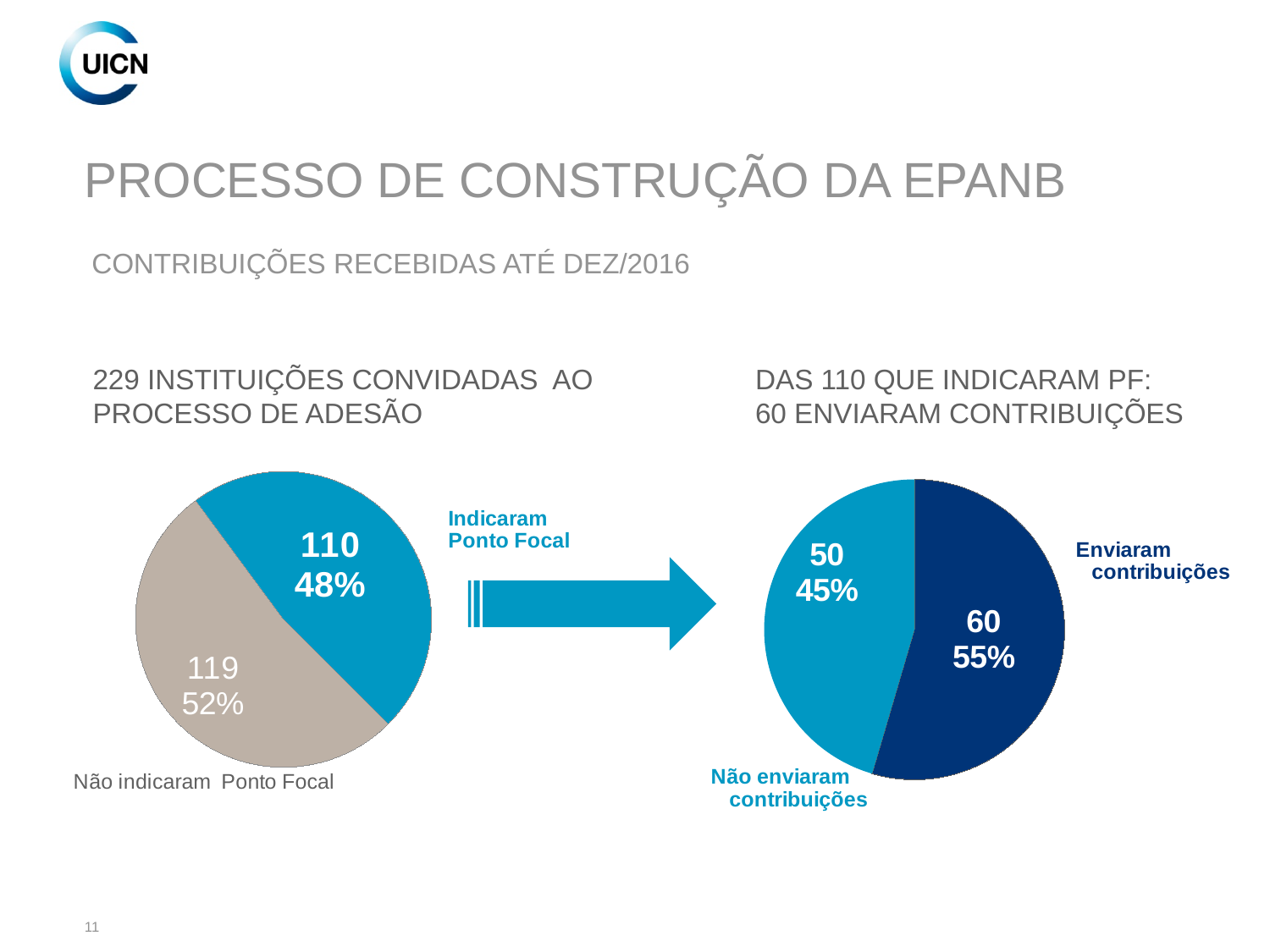
In the left pie chart, what is the difference between the Não indicaram Ponto Focal count and the Indicaram Ponto Focal count? 9 How many slices does the right pie chart have? 2 In the left pie chart, which slice is larger: Indicaram Ponto Focal or Não indicaram Ponto Focal? Não indicaram Ponto Focal In the right pie chart, which slice is the largest? Enviaram contribuições In the left pie chart, how many institutions indicated a Ponto Focal (Indicaram Ponto Focal)? 110 In the right pie chart, what percentage share is shown for Não enviaram contribuições? 45% In the right pie chart, how many institutions sent contributions (Enviaram contribuições)? 60 In the right pie chart, what is the total of the two slice counts? 110 In the left pie chart, what percentage share is shown for Não indicaram Ponto Focal? 52% In the left pie chart, what is the count for Não indicaram Ponto Focal? 119 What type of chart is used on the left side of the slide? Pie chart In the right pie chart, what is the difference between the Enviaram contribuições count and the Não enviaram contribuições count? 10